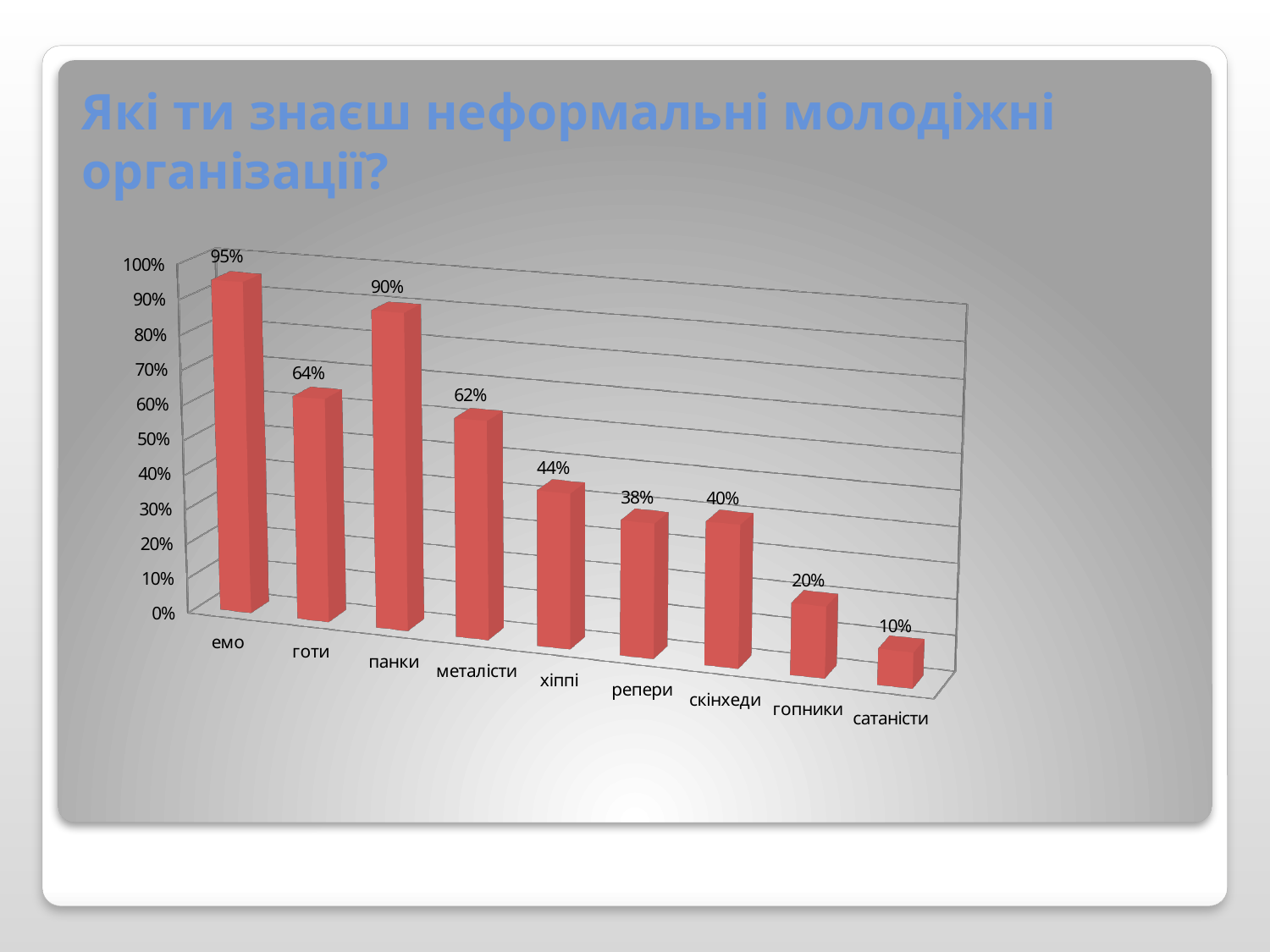
How many categories are shown on the chart? 9 What is the difference between the values for емо and сатаністи? 85% What is the value for металісти? 62% What is the value for емо? 95% What kind of chart is shown on the slide? bar chart Which is larger, the value for репери or the value for скінхеди? скінхеди Which category has the lowest value? сатаністи What is the difference between the values for панки and готи? 26% Which category has the highest value? емо What is the value for гопники? 20% What is the title of the slide? Які ти знаєш неформальні молодіжні організації? Is the value for хіппі greater or less than 50%? less